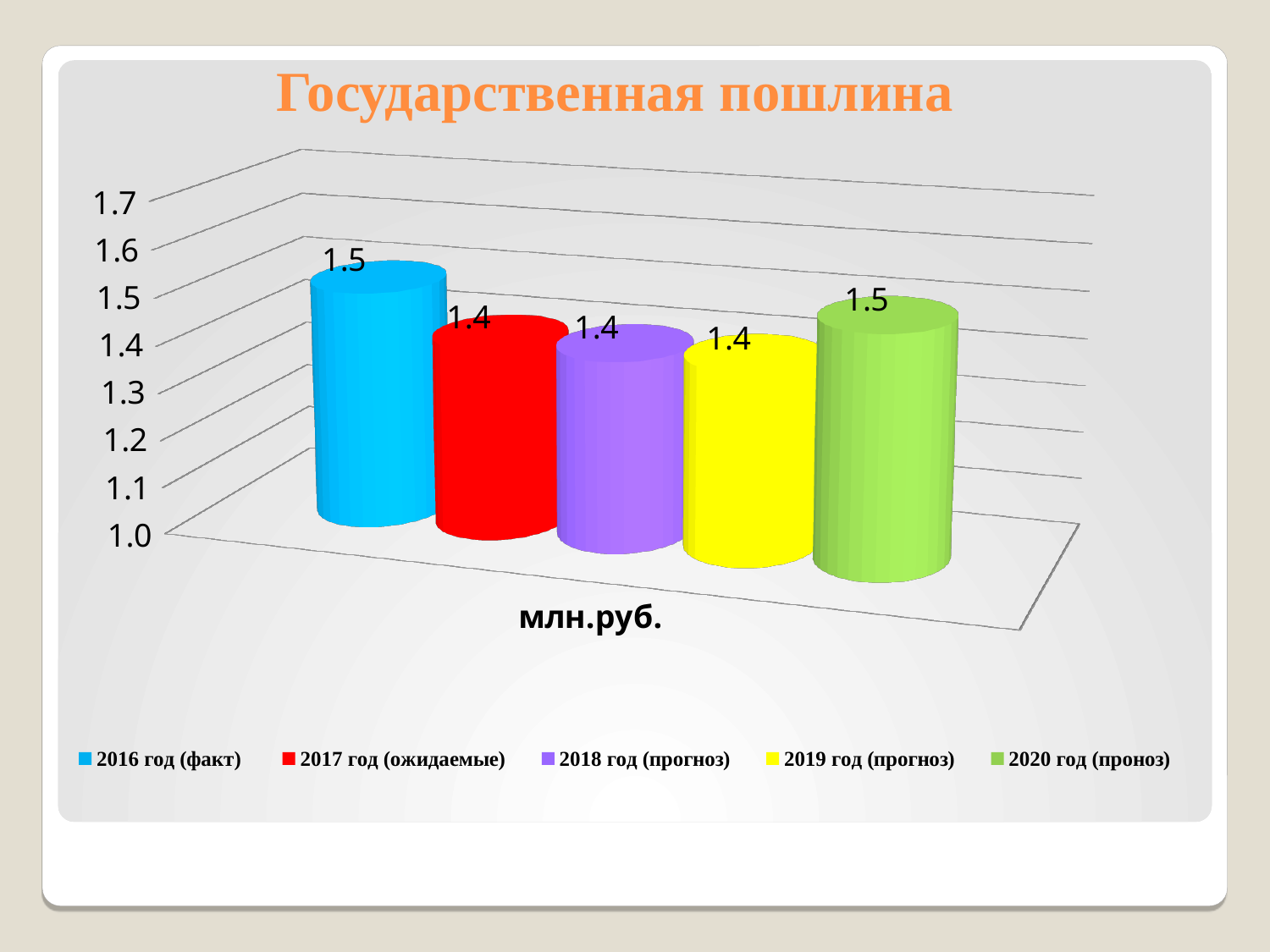
What kind of chart is shown on the slide? Bar chart What is the value for 2020 год (проноз)? 1.5 How many series does the legend list? 5 How many bars are plotted on the chart? 5 What is the value for 2016 год (факт)? 1.5 What unit is shown below the bars on the chart? млн.руб. What is the difference between the value for 2016 год (факт) and the value for 2017 год (ожидаемые)? 0.1 Which is larger, the value for 2016 год (факт) or the value for 2019 год (прогноз)? 2016 год (факт) What is the value for 2017 год (ожидаемые)? 1.4 What is the value for 2018 год (прогноз)? 1.4 Is the value for 2020 год (проноз) greater or less than 1.2? greater What is the title of the chart? Государственная пошлина